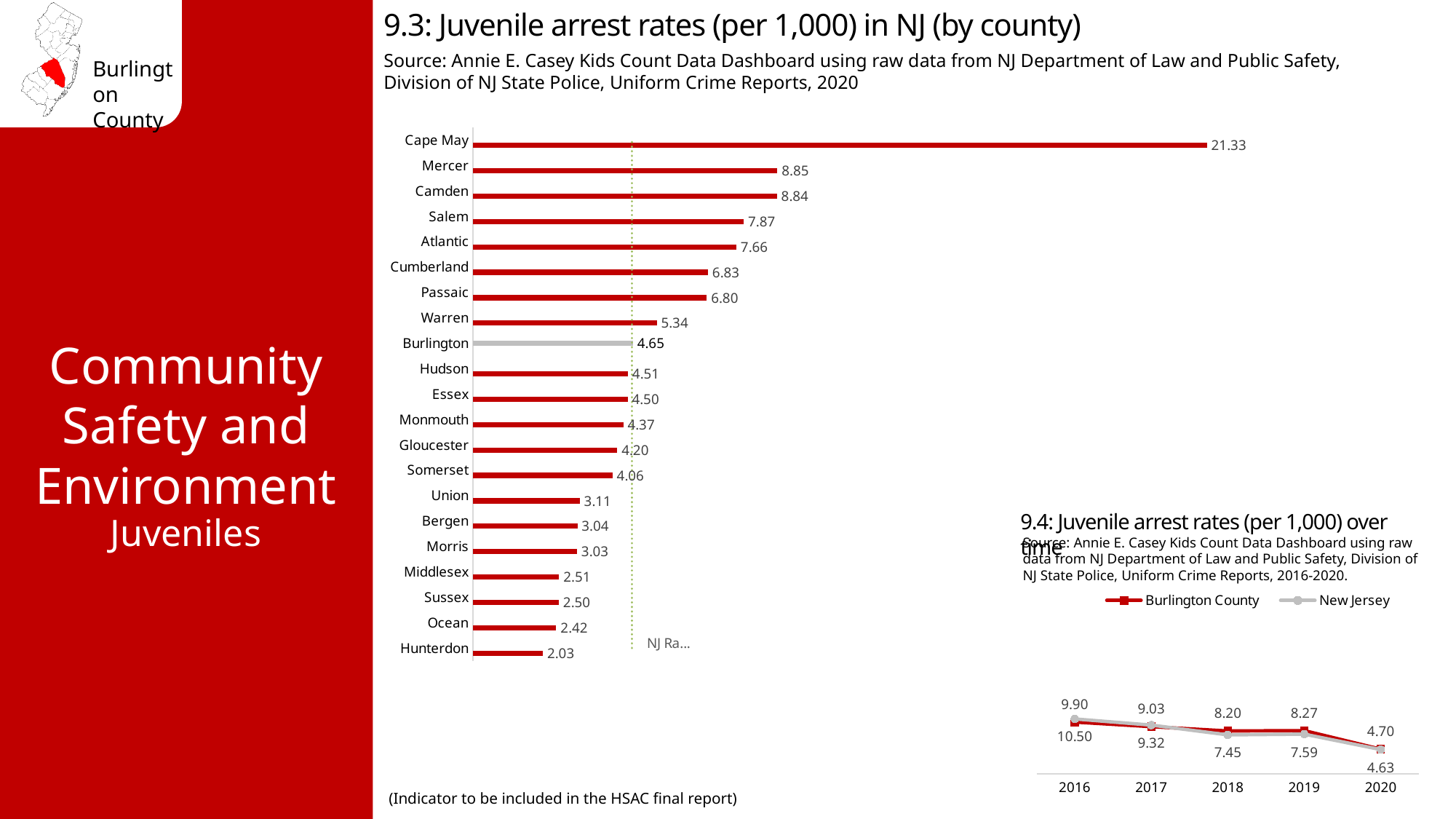
In chart 9.4 (Juvenile arrest rates over time), what kind of chart is used? Line chart In chart 9.3 (Juvenile arrest rates by county), what is the difference between the rates for Cape May and Mercer? 12.48 In chart 9.4 (Juvenile arrest rates over time), how many series does the legend list? 2 In chart 9.3 (Juvenile arrest rates by county), what is the juvenile arrest rate for Burlington? 4.65 In chart 9.3 (Juvenile arrest rates by county), how many counties are shown? 21 In chart 9.3 (Juvenile arrest rates by county), what is the juvenile arrest rate for Passaic? 6.80 In chart 9.3 (Juvenile arrest rates by county), what colour is the Burlington bar? Gray In chart 9.3 (Juvenile arrest rates by county), which county has the highest juvenile arrest rate? Cape May In chart 9.4 (Juvenile arrest rates over time), how many years are shown on the x axis? 5 In chart 9.3 (Juvenile arrest rates by county), which has a higher juvenile arrest rate, Salem or Atlantic? Salem In chart 9.3 (Juvenile arrest rates by county), which county has the lowest juvenile arrest rate? Hunterdon In chart 9.3 (Juvenile arrest rates by county), what kind of chart is used? Bar chart